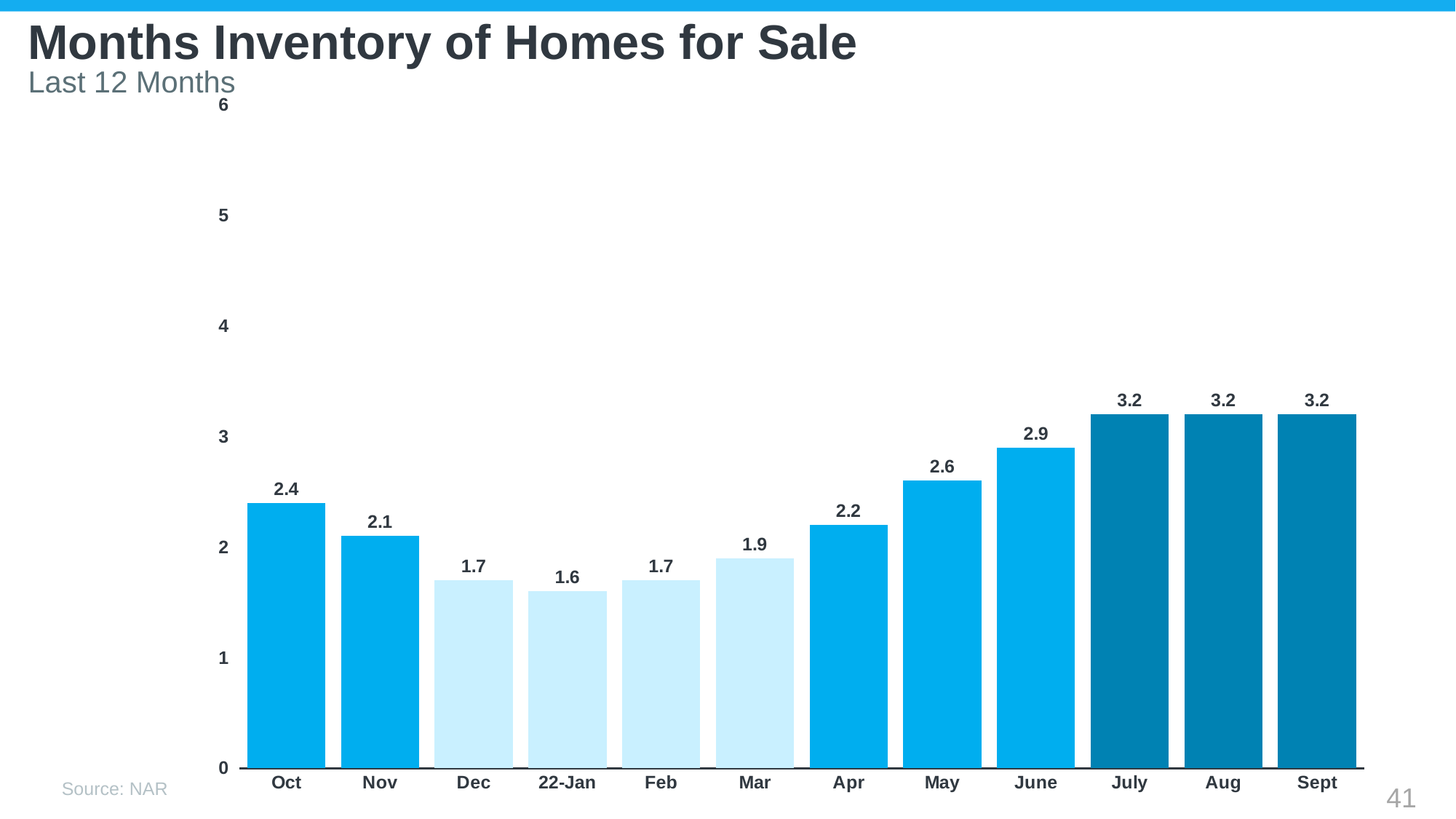
What is the months inventory value for Oct? 2.4 Which month has the lowest months inventory? 22-Jan What is the title of the chart? Months Inventory of Homes for Sale What is the difference between the values for Sept and Mar? 1.3 What is the months inventory value for June? 2.9 Which is larger, the value for May or the value for Apr? May What kind of chart is shown on the slide? bar chart Do the values rise or fall from Mar to July? rise Is the value for Aug greater or less than 3? greater What is the difference between the values for Oct and Nov? 0.3 How many months are shown on the x axis? 12 What is the months inventory value for 22-Jan? 1.6